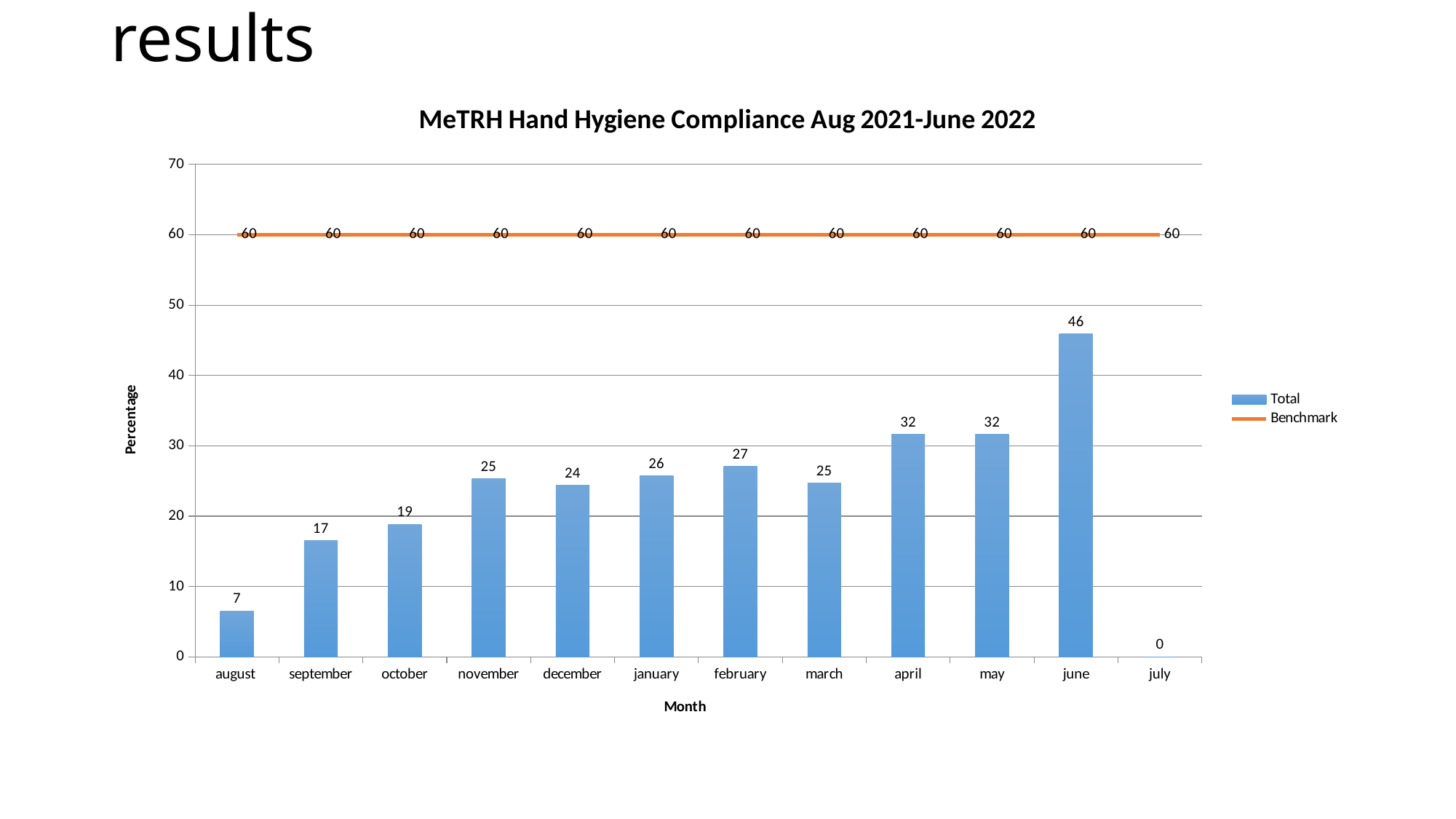
How many months are shown on the x axis? 12 What is the title of the chart? MeTRH Hand Hygiene Compliance Aug 2021-June 2022 Which month has the lowest Total value? july Which month has the highest Total value? june What is the Total value for august? 7 What is the Benchmark value shown for each month? 60 What is the difference between the Total values for june and may? 14 What kind of chart is used for the Total series? bar chart How many series does the legend list? 2 Is the Total value for april greater or less than 30? greater Which has a larger Total value, february or march? february What is the Total value for june? 46